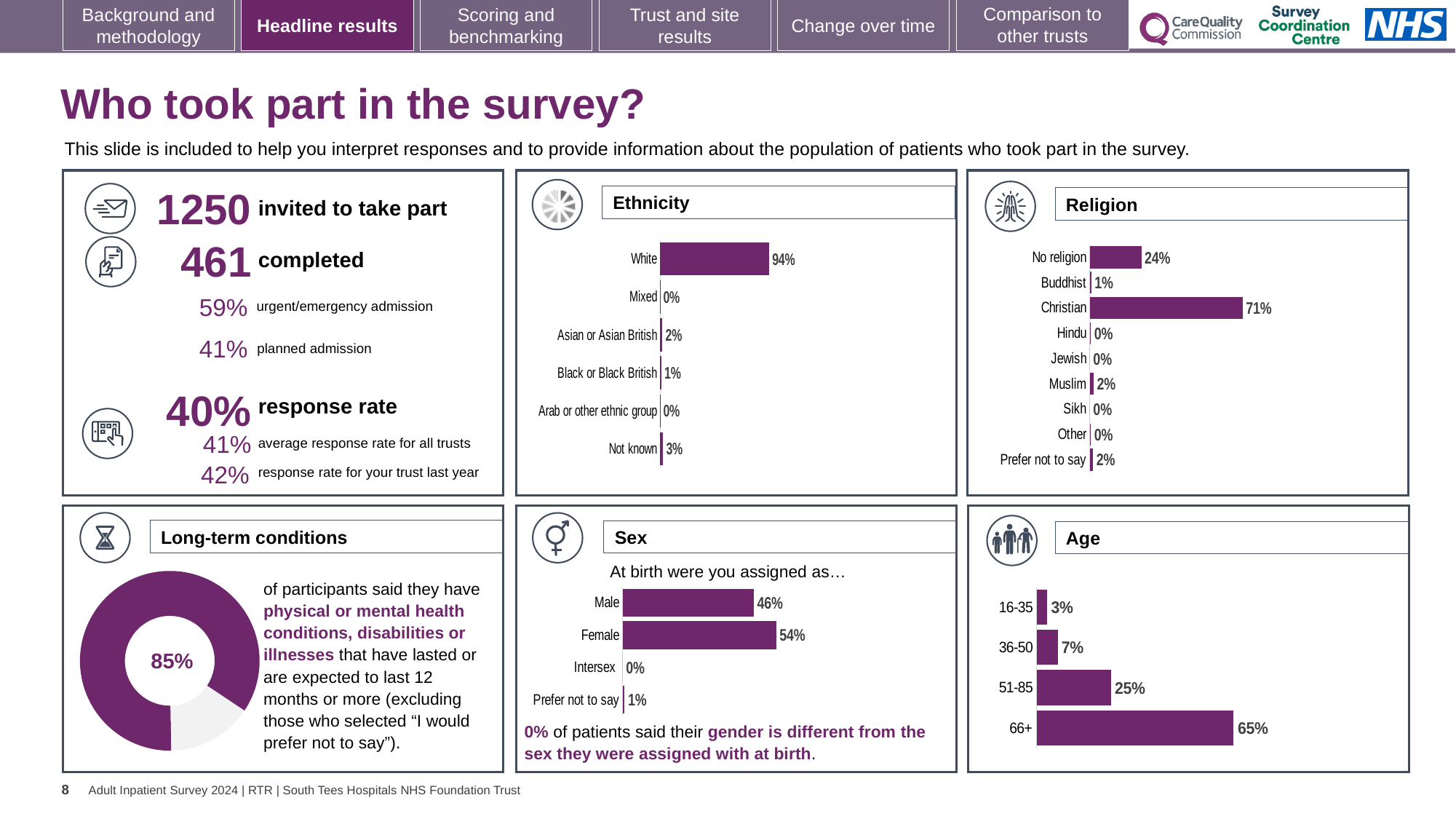
What kind of chart is the Age chart? Bar chart In the Age chart, do the values rise or fall from the 16-35 group to the 66+ group? Rise In the Sex chart, which is larger, Male or Female? Female In the Ethnicity chart, what percentage of respondents were White? 94% In the Religion chart, what is the value for No religion? 24% In the Age chart, what is the difference between the 66+ and 51-85 values? 40% How many categories does the Ethnicity chart show? 6 In the Long-term conditions chart, what share of participants said they have physical or mental health conditions, disabilities or illnesses? 85% What kind of chart is the Long-term conditions chart? Doughnut chart In the Religion chart, which category has the highest value? Christian In the Sex chart, what is the value for Prefer not to say? 1% How many categories does the Religion chart show? 9